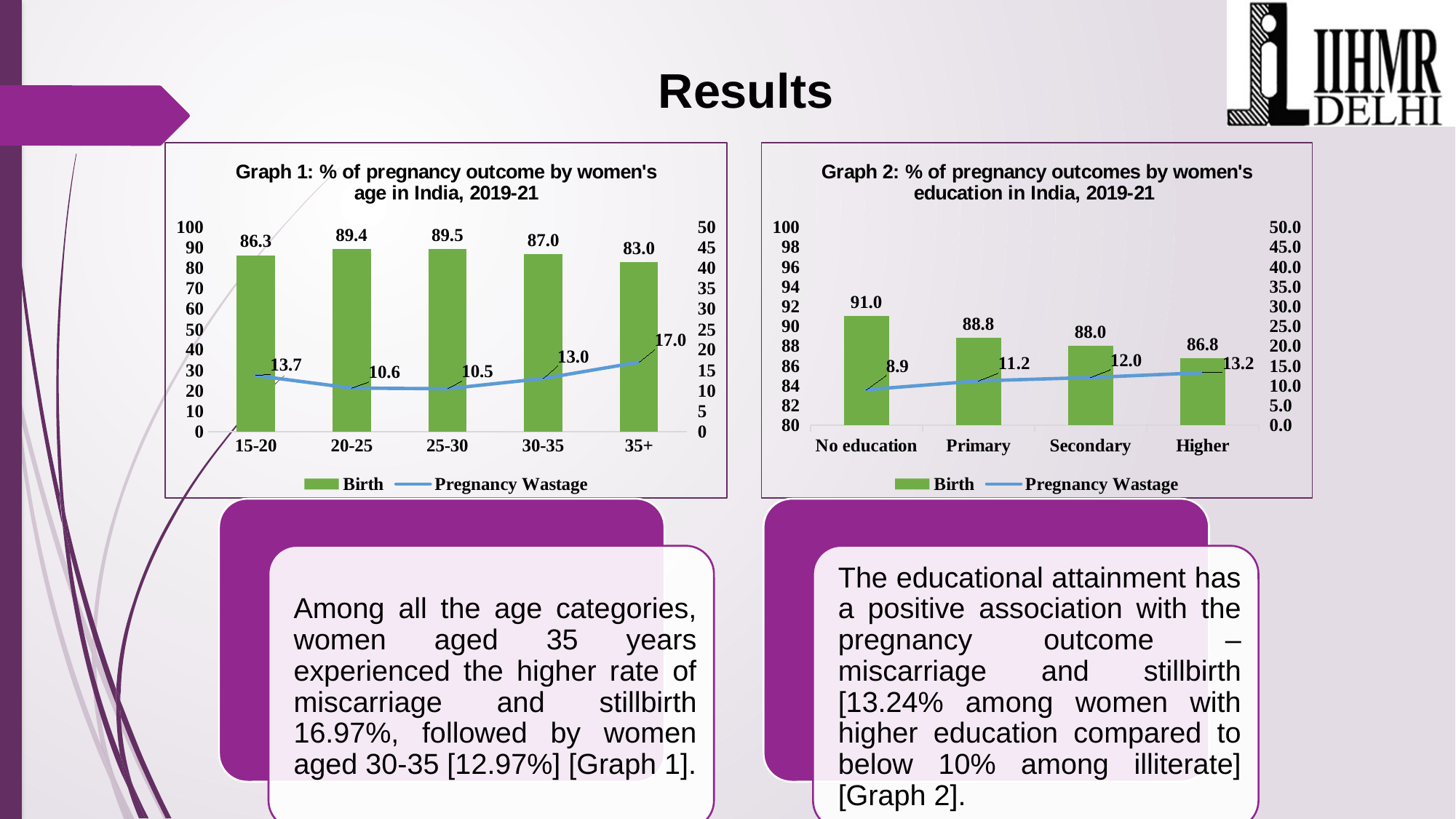
In Graph 1, what is the Pregnancy Wastage value for women aged 35+? 17.0 In Graph 2, which education category has the highest Birth value? No education In Graph 2, does the Pregnancy Wastage line rise or fall from No education to Higher? rise In Graph 2, what is the Pregnancy Wastage value for Secondary education? 12.0 In Graph 1, how many age groups are shown on the x axis? 5 In Graph 2, what is the Birth value for women with no education? 91.0 In Graph 1, which age group has the lowest Birth value? 35+ In Graph 1, which age group has the highest Pregnancy Wastage value? 35+ In Graph 1, what is the Birth value for the 25-30 age group? 89.5 In Graph 1, what is the difference between the Pregnancy Wastage values for 35+ and 30-35? 4.0 In Graph 2, what is the difference between the Birth values for No education and Higher? 4.2 How many series does the legend of Graph 2 list? 2